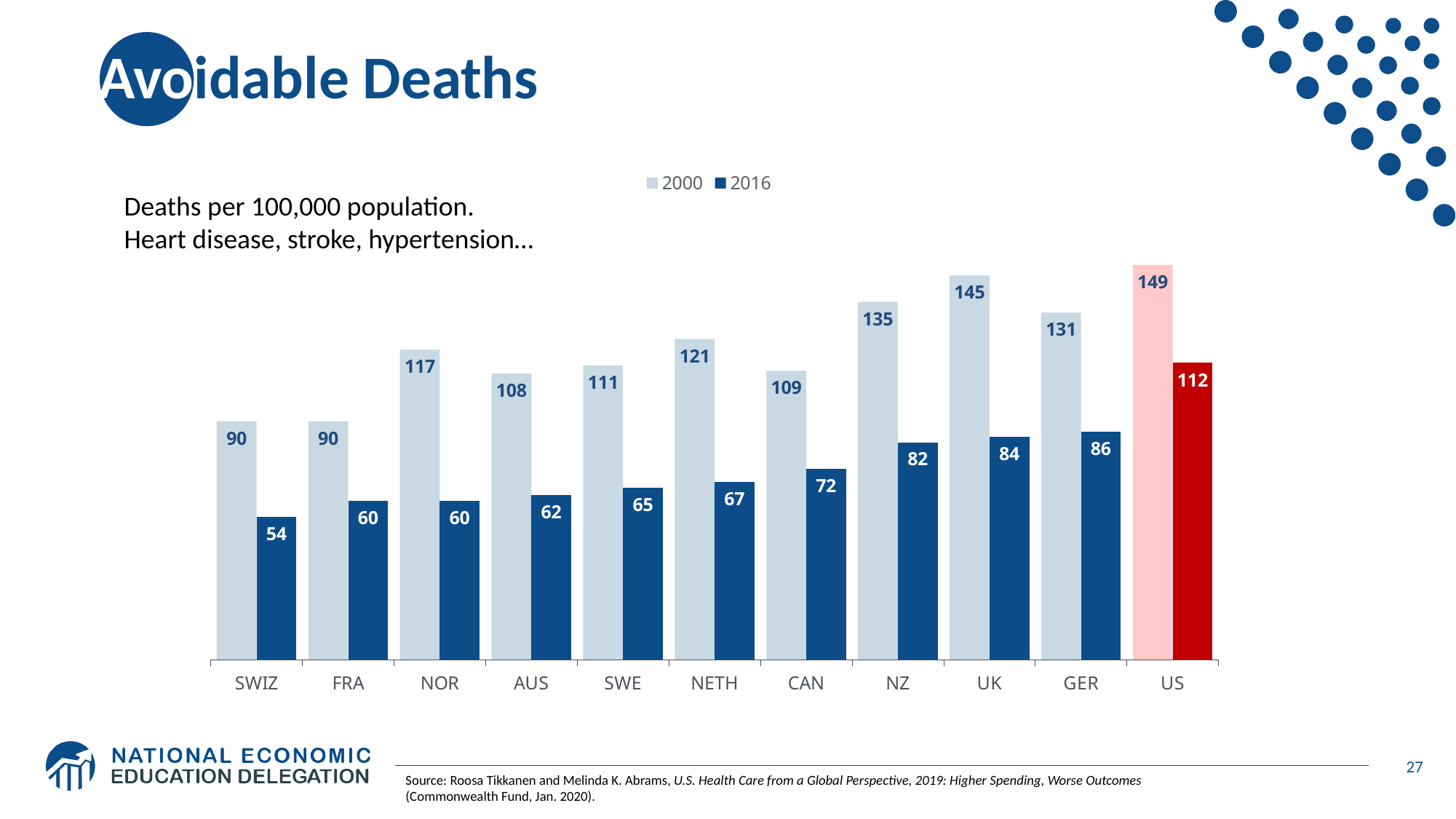
What is the difference between the 2000 and 2016 values for Norway (NOR)? 57 Which country had the highest value in 2000? US Which is larger: the 2016 value for the UK or the 2016 value for NZ? UK What is the difference between the US values for 2000 and 2016? 37 What was the value for Germany (GER) in 2016? 86 What was the value for the US in 2016? 112 How many countries are shown on the x axis? 11 Which two years are listed in the legend? 2000 and 2016 What kind of chart is shown on the slide? Bar chart How many series does the legend list? 2 What was the value for Switzerland (SWIZ) in 2000? 90 Which country had the lowest value in 2016? SWIZ